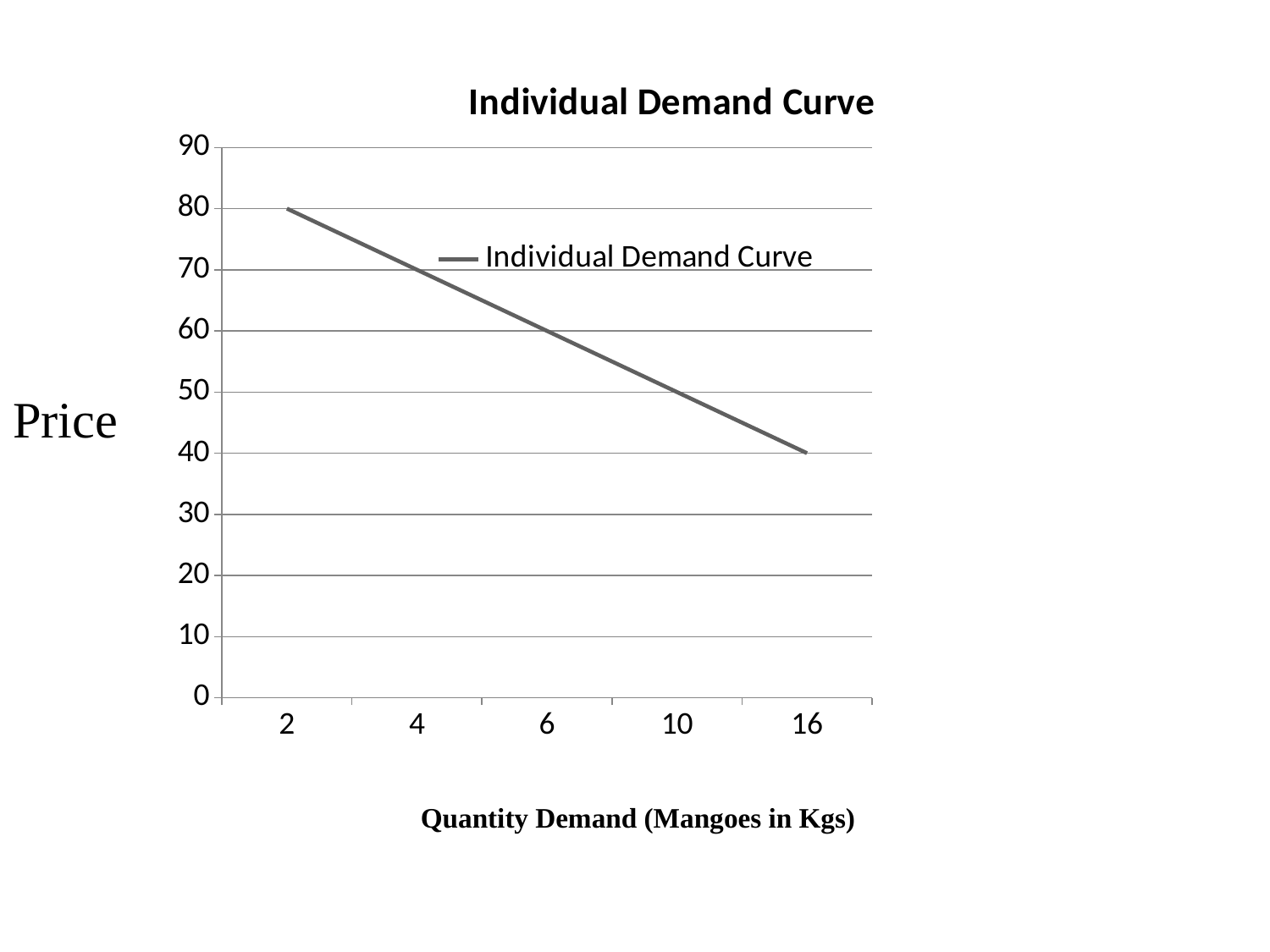
What is the difference between the price at quantity 2 and the price at quantity 16? 40 At which quantity demanded is the price lowest? 16 What is the title of the chart? Individual Demand Curve Which has a higher price: quantity 4 or quantity 10? quantity 4 What type of chart is shown on the slide? line chart What is the price when the quantity demanded is 16? 40 What is the label of the x axis? Quantity Demand (Mangoes in Kgs) Does the price rise or fall as quantity demanded increases along the x axis? fall What is the price when the quantity demanded is 2? 80 How many quantity points are plotted on the x axis? 5 What is the price when the quantity demanded is 6? 60 At which quantity demanded is the price highest? 2